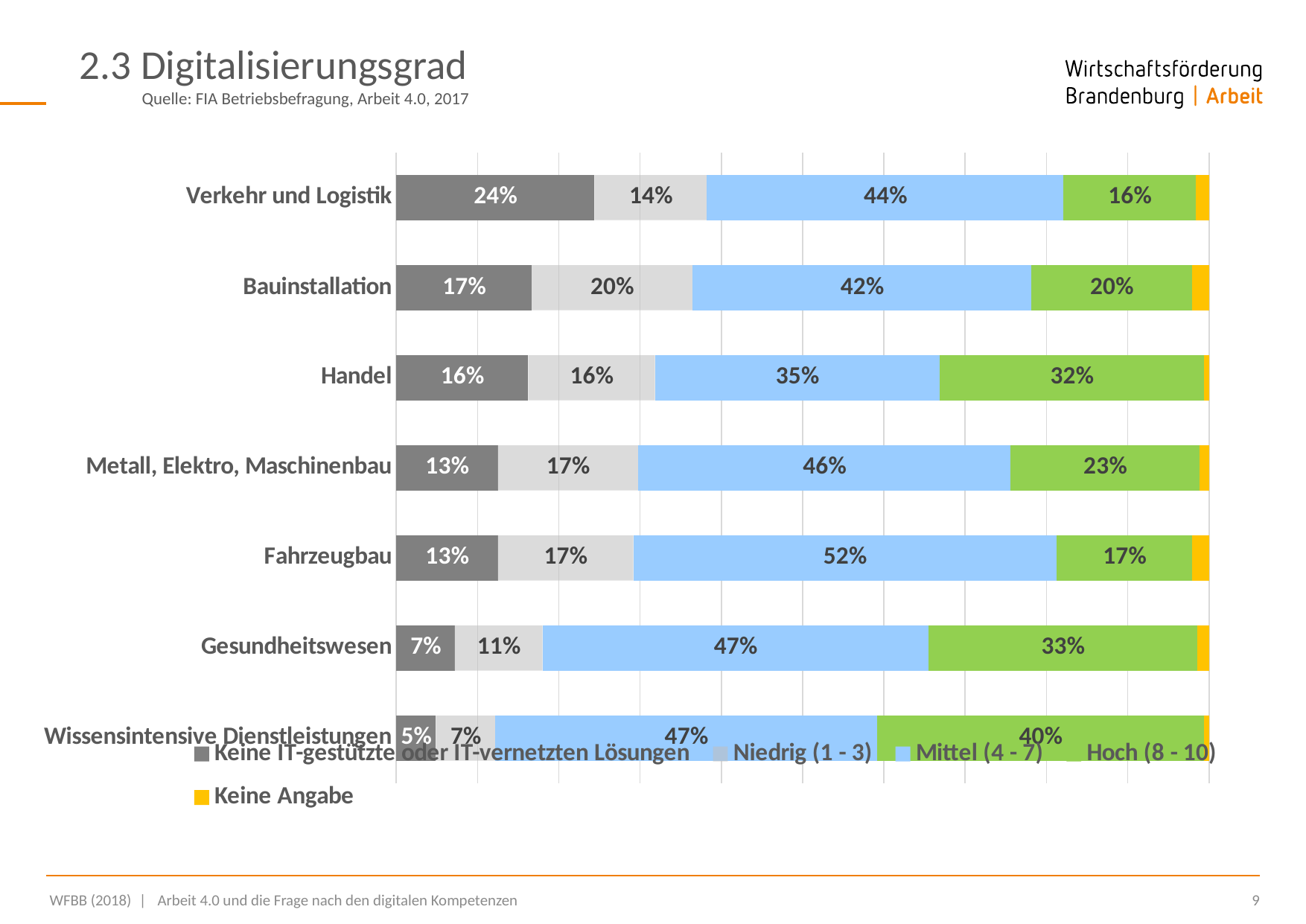
What is the value of the Mittel (4 - 7) segment for Fahrzeugbau? 52% How many categories (industries) are shown in the chart? 7 Which has the larger Niedrig (1 - 3) value, Bauinstallation or Verkehr und Logistik? Bauinstallation Which category has the highest Hoch (8 - 10) value? Wissensintensive Dienstleistungen What is the value of the Hoch (8 - 10) segment for Handel? 32% What kind of chart is shown on the slide? Stacked bar chart What is the difference between the Mittel (4 - 7) values for Fahrzeugbau and Verkehr und Logistik? 8 percentage points What is the value of the 'Keine IT-gestützte oder IT-vernetzten Lösungen' segment for Gesundheitswesen? 7% Which category has the lowest Niedrig (1 - 3) value? Wissensintensive Dienstleistungen How many series does the legend list? 5 Which colour represents 'Keine Angabe' in the legend? Yellow Which category has the highest value for 'Keine IT-gestützte oder IT-vernetzten Lösungen'? Verkehr und Logistik